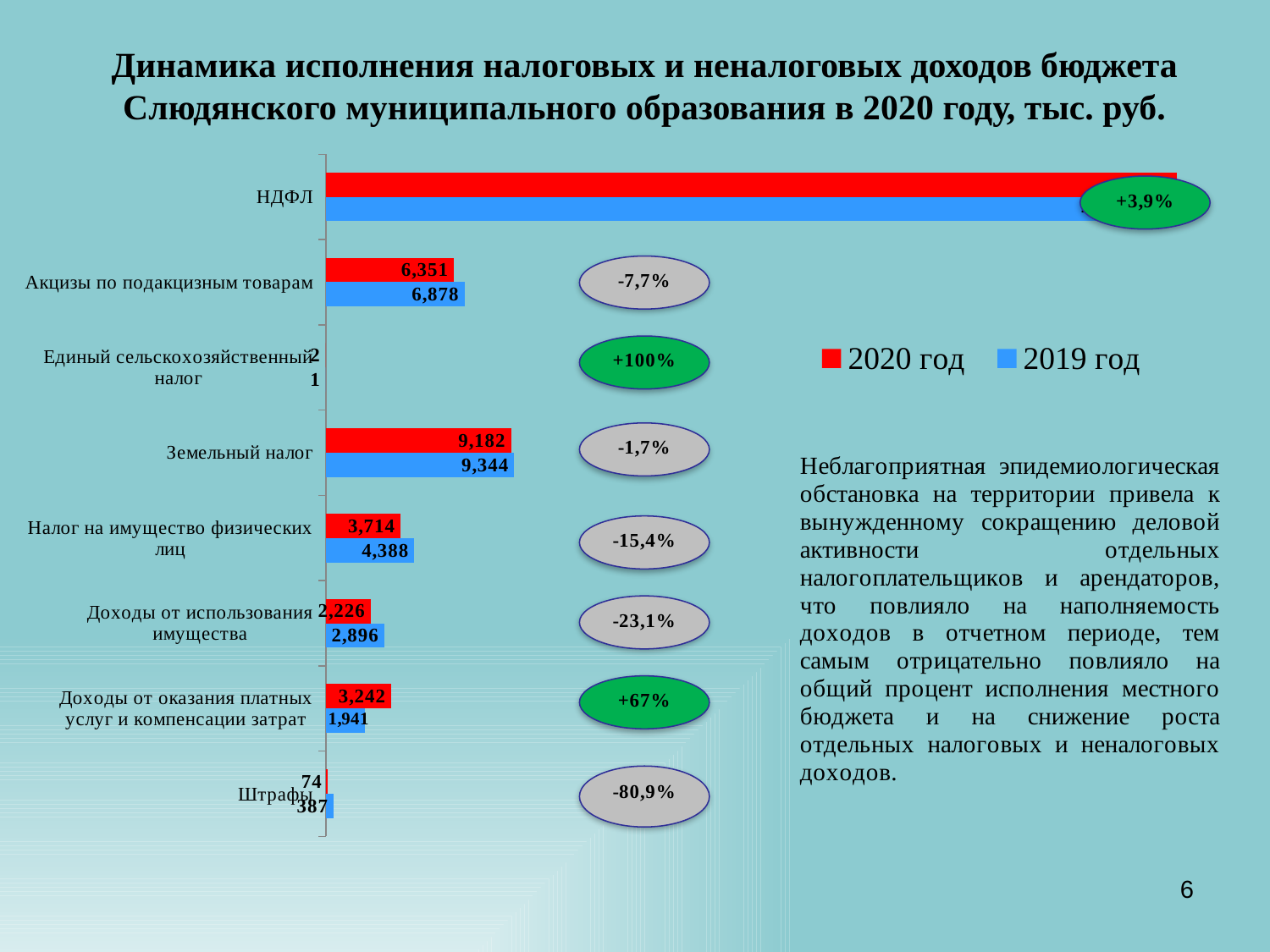
What is the 2020 год value for Доходы от оказания платных услуг и компенсации затрат? 3,242 What is the 2019 год value for Штрафы? 387 Which category has the highest values in both series? НДФЛ What is the difference between the 2019 год and 2020 год values for Налог на имущество физических лиц? 674 How many series does the legend list? 2 What is the 2020 год value for Акцизы по подакцизным товарам? 6,351 How many categories are plotted on the chart? 8 What kind of chart is shown on the slide? bar chart What is the 2019 год value for Земельный налог? 9,344 For Доходы от оказания платных услуг и компенсации затрат, which series has the larger value, 2020 год or 2019 год? 2020 год Which colour represents the 2019 год series in the legend? blue Which category has the lowest values in both series? Единый сельскохозяйственный налог